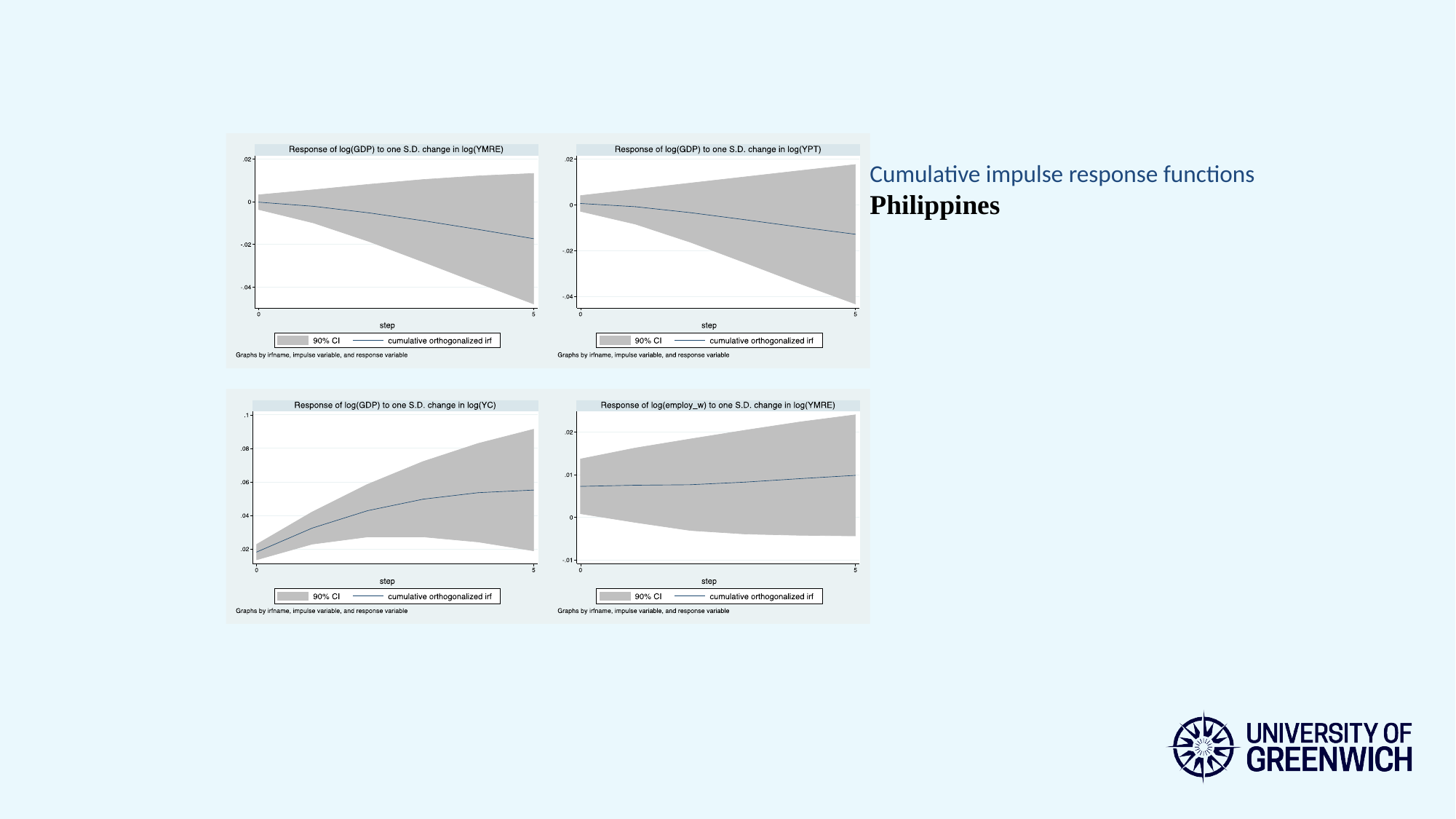
In the top-right chart (response of log(GDP) to log(YPT)), does the cumulative orthogonalized irf line rise or fall along the step axis? fall In the bottom-left chart (response of log(GDP) to log(YC)), does the cumulative orthogonalized irf line rise or fall as step increases? rise In the top-left chart (response of log(GDP) to log(YMRE)), is the cumulative orthogonalized irf value at step 5 greater or less than 0? less What is the title of the bottom-right chart? Response of log(employ_w) to one S.D. change in log(YMRE) In the bottom-left chart (response of log(GDP) to log(YC)), is the cumulative orthogonalized irf value at step 5 greater or less than .04? greater In the bottom-left chart (response of log(GDP) to log(YC)), is the cumulative orthogonalized irf value at step 0 greater or less than .04? less How many charts are shown on the slide? 4 In the top-left chart (response of log(GDP) to log(YMRE)), does the cumulative orthogonalized irf line rise or fall as step increases from 0 to 5? fall How many entries does the legend of the bottom-right chart (response of log(employ_w) to log(YMRE)) list? 2 What kind of chart is the top-left chart, 'Response of log(GDP) to one S.D. change in log(YMRE)'? line chart